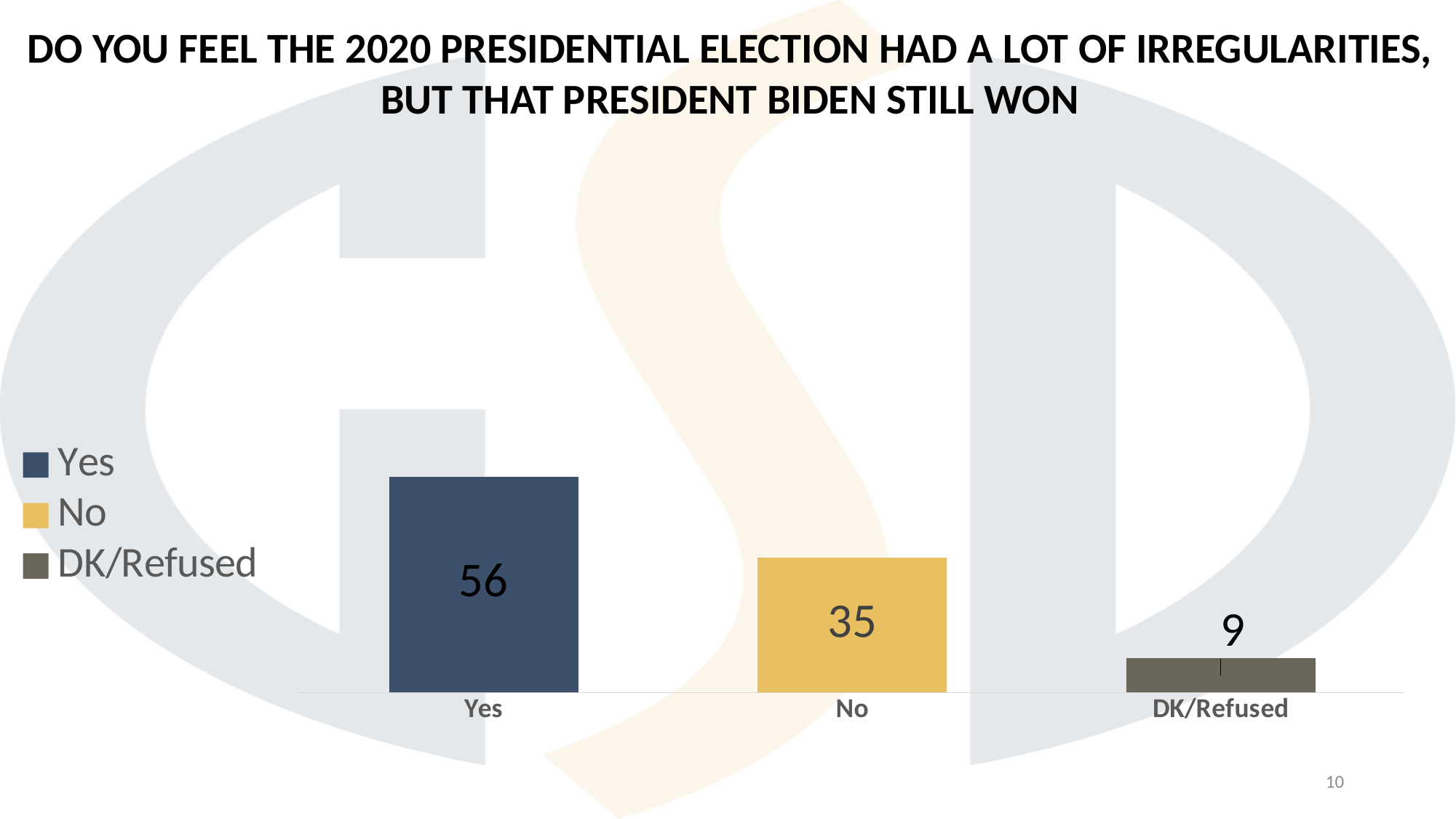
What is the difference between the values for No and DK/Refused? 26 How many entries does the legend list? 3 What is the value for No? 35 What is the value for DK/Refused? 9 What is the difference between the values for Yes and No? 21 Which category has the lowest value? DK/Refused Which category has the highest value? Yes Which is larger, the value for Yes or the value for No? Yes What colour is the bar for No? Yellow How many categories are shown in the chart? 3 What kind of chart is shown on the slide? Bar chart What is the value for Yes? 56